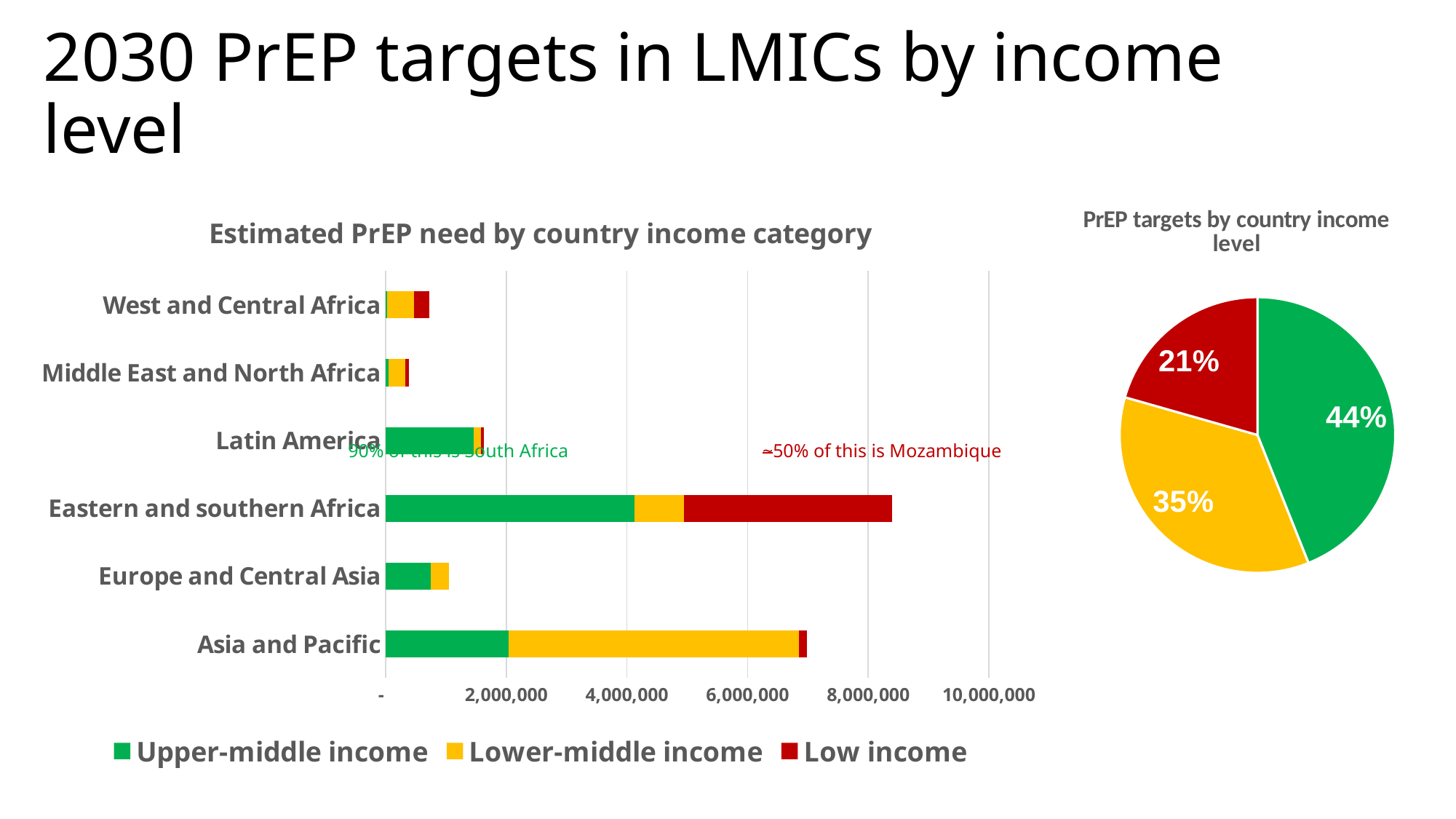
On the pie chart titled 'PrEP targets by country income level', what share does the green (Upper-middle income) slice have? 44% On the bar chart titled 'Estimated PrEP need by country income category', is the total value for Asia and Pacific greater or less than 6,000,000? greater On the bar chart titled 'Estimated PrEP need by country income category', is the total value for Europe and Central Asia greater or less than 2,000,000? less On the bar chart titled 'Estimated PrEP need by country income category', which region has the shortest total bar? Middle East and North Africa On the bar chart titled 'Estimated PrEP need by country income category', which has the larger total bar: Asia and Pacific or Europe and Central Asia? Asia and Pacific On the bar chart titled 'Estimated PrEP need by country income category', is the total value for Eastern and southern Africa greater or less than 8,000,000? greater On the bar chart titled 'Estimated PrEP need by country income category', which region has the longest total bar? Eastern and southern Africa What kind of chart is 'Estimated PrEP need by country income category'? Stacked bar chart On the pie chart titled 'PrEP targets by country income level', what is the difference between the largest slice and the smallest slice? 23 percentage points How many series does the legend of the bar chart titled 'Estimated PrEP need by country income category' list? 3 How many regions are shown on the bar chart titled 'Estimated PrEP need by country income category'? 6